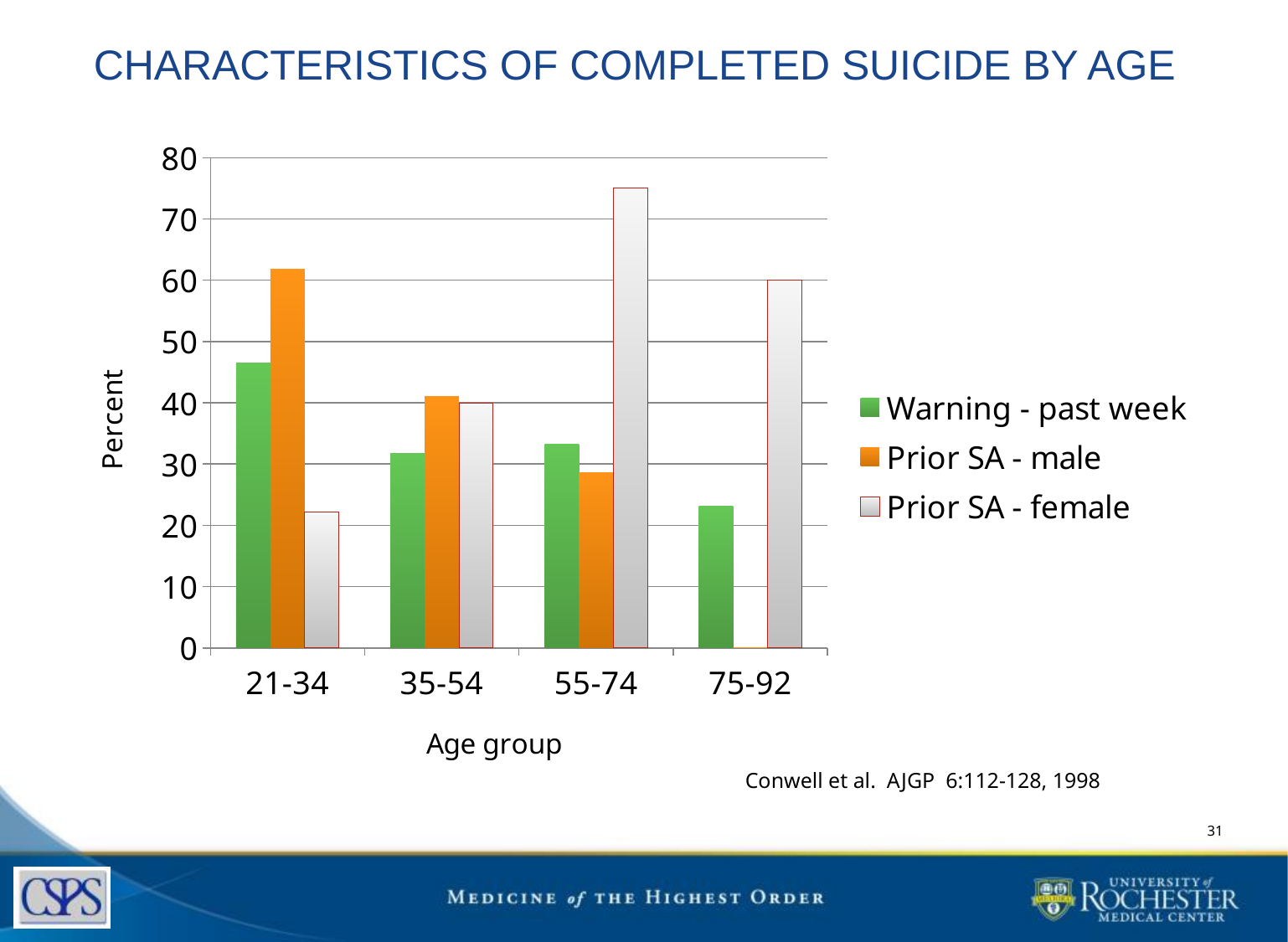
What is the label on the y axis? Percent What kind of chart is shown on the slide? bar chart Do the values for Prior SA - male rise or fall from the 21-34 age group to the 55-74 age group? fall How many age groups are shown on the x axis? 4 For the 55-74 age group, which is larger: Prior SA - female or Warning - past week? Prior SA - female Which age group has the lowest value for Warning - past week? 75-92 Is the value for Prior SA - male in the 21-34 age group greater or less than 50? greater Is the value for Prior SA - female in the 55-74 age group greater or less than 70? greater Which age group has the highest value for Warning - past week? 21-34 For the 21-34 age group, which is larger: Prior SA - male or Prior SA - female? Prior SA - male How many series does the legend list? 3 Which age group has the highest value for Prior SA - female? 55-74